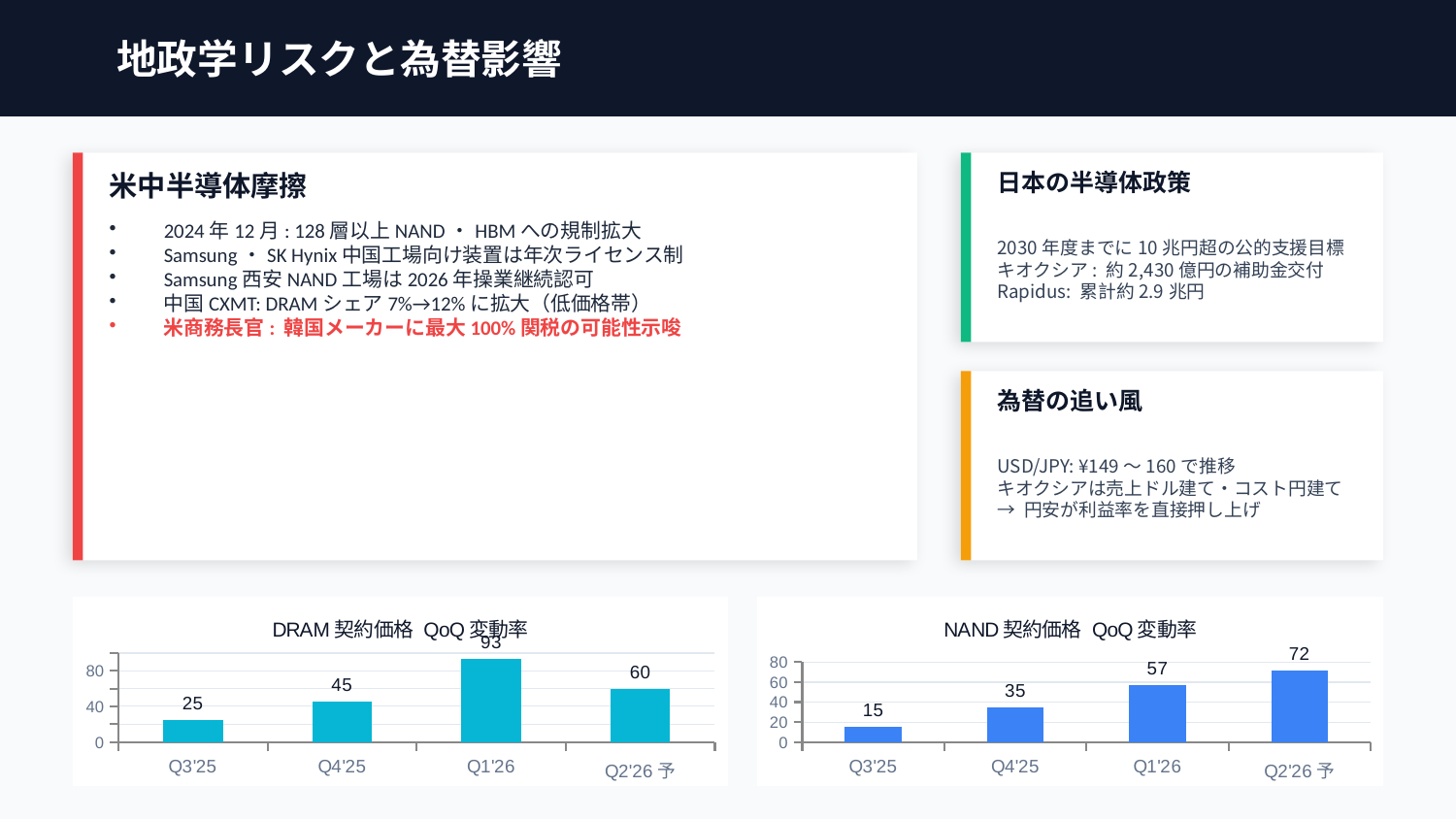
In the DRAM 契約価格 QoQ 変動率 chart, which quarter has the highest value? Q1'26 In the DRAM 契約価格 QoQ 変動率 chart, is the value for Q2'26 予 greater or less than 40? greater What kind of chart is the DRAM 契約価格 QoQ 変動率 chart? bar chart In the DRAM 契約価格 QoQ 変動率 chart, what is the difference between the values for Q1'26 and Q2'26 予? 33 In the NAND 契約価格 QoQ 変動率 chart, what is the difference between the values for Q2'26 予 and Q3'25? 57 In the NAND 契約価格 QoQ 変動率 chart, what is the value for Q4'25? 35 In the NAND 契約価格 QoQ 変動率 chart, which quarter has the highest value? Q2'26 予 In the NAND 契約価格 QoQ 変動率 chart, which quarter has the lowest value? Q3'25 In the NAND 契約価格 QoQ 変動率 chart, do the values rise or fall from Q3'25 to Q2'26 予? rise In the DRAM 契約価格 QoQ 変動率 chart, what is the value for Q1'26? 93 Which is larger: the DRAM 契約価格 QoQ 変動率 value for Q4'25 or the NAND 契約価格 QoQ 変動率 value for Q4'25? DRAM (45) How many quarters are shown on the x axis of the NAND 契約価格 QoQ 変動率 chart? 4